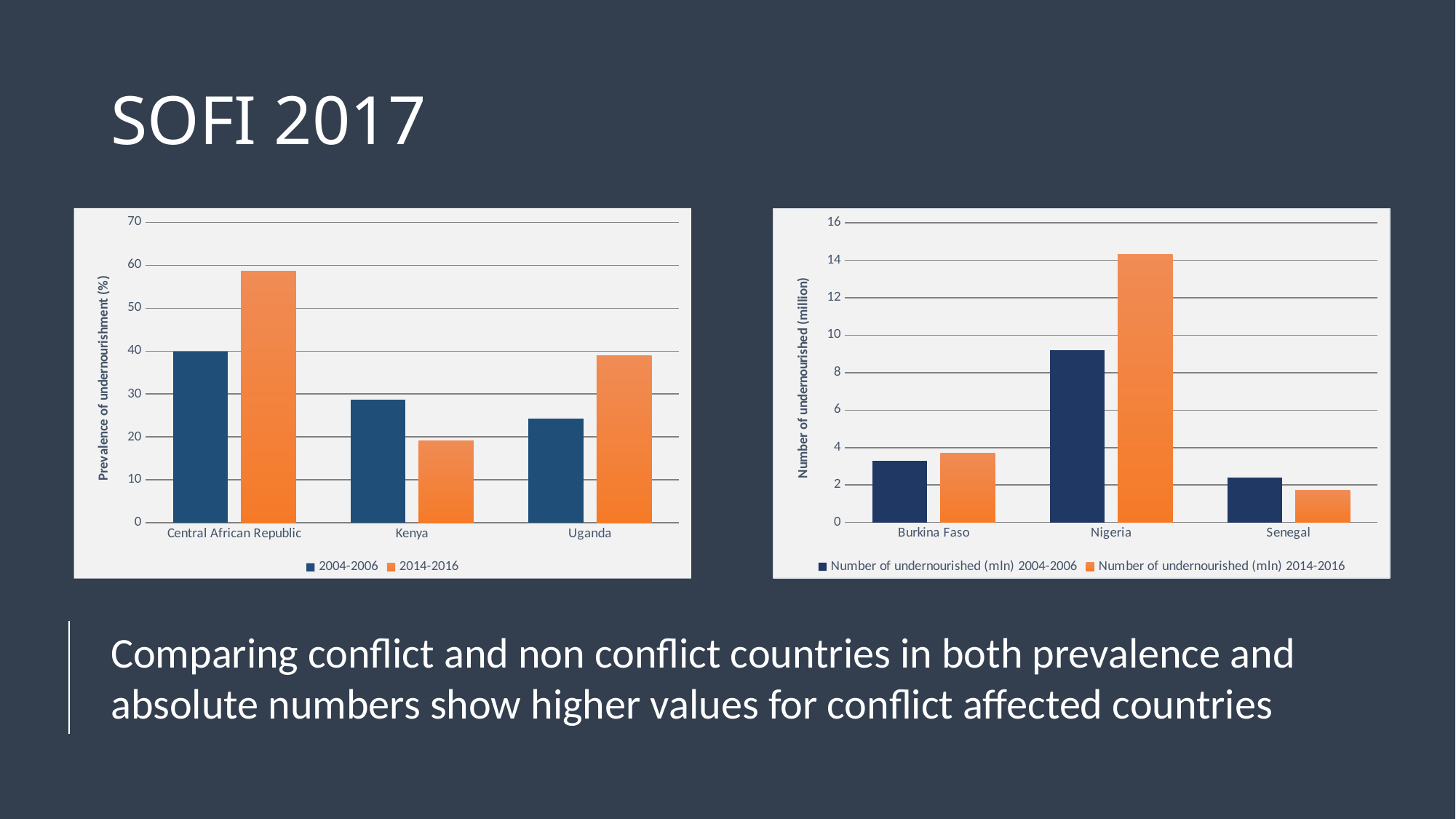
On the right chart (Number of undernourished), is the 2014-2016 value for Nigeria greater or less than 12? greater On the left chart (Prevalence of undernourishment), which is larger for Kenya: the 2004-2006 value or the 2014-2016 value? 2004-2006 How many series does the legend of the left chart (Prevalence of undernourishment) list? 2 On the right chart (Number of undernourished), which country has the highest 2014-2016 value? Nigeria On the right chart (Number of undernourished), which is larger for Senegal: the 2004-2006 value or the 2014-2016 value? 2004-2006 On the left chart (Prevalence of undernourishment), is the 2014-2016 value for Central African Republic greater or less than 50? greater What is the y-axis label of the right chart? Number of undernourished (million) What kind of chart is the left chart (Prevalence of undernourishment)? bar chart How many countries are shown on the left chart (Prevalence of undernourishment)? 3 On the left chart (Prevalence of undernourishment), which country has the lowest 2014-2016 value? Kenya On the left chart (Prevalence of undernourishment), which country has the highest 2014-2016 value? Central African Republic On the right chart (Number of undernourished), which country has the lowest 2014-2016 value? Senegal